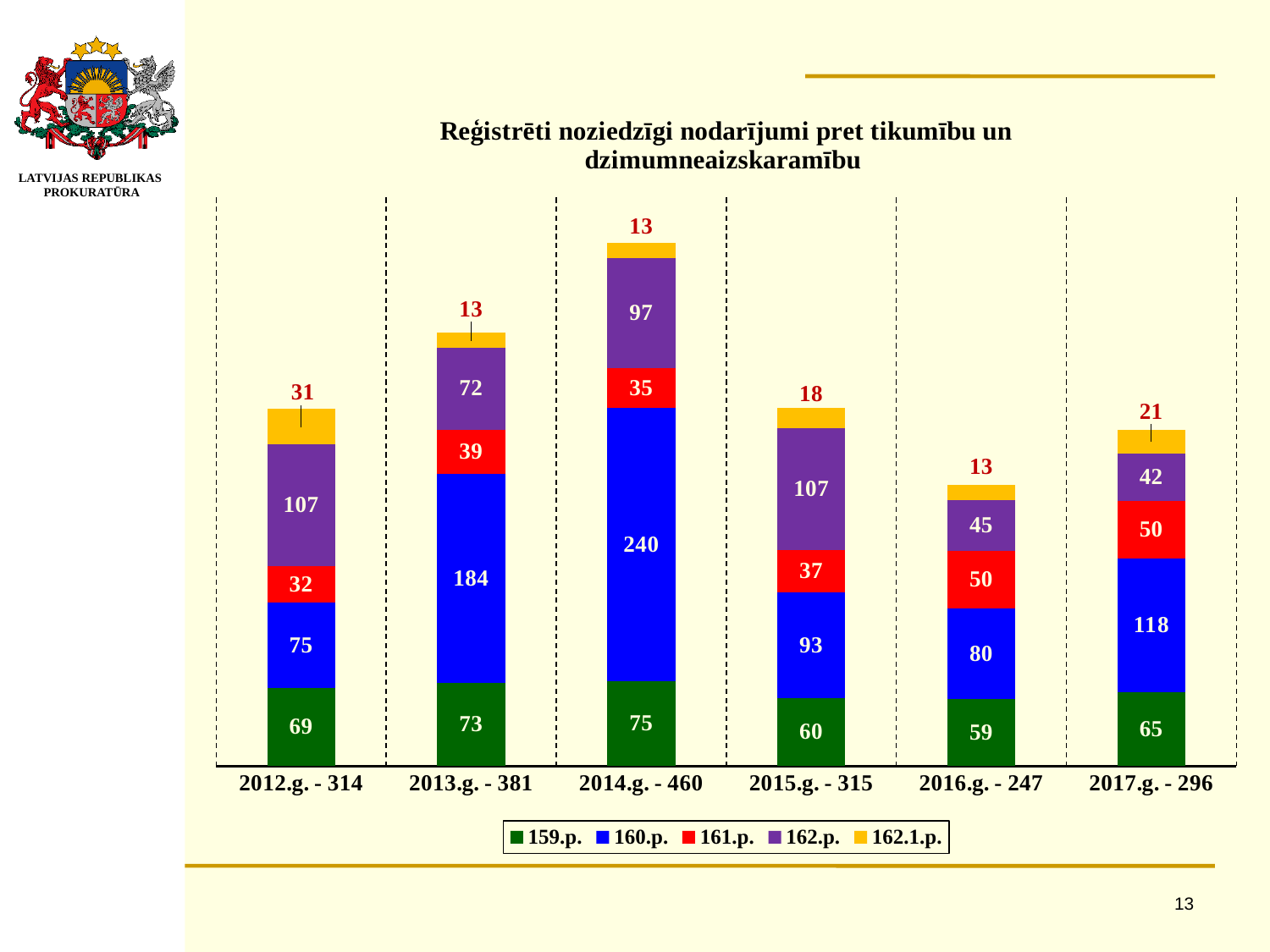
What type of chart is shown on the slide? stacked bar chart Which year has the lowest total of registered offences? 2016 Which year has the highest total of registered offences? 2014 What is the value for 162.p. in 2015? 107 How many years (categories) are shown on the x axis? 6 How many series does the legend list? 5 Which is larger, the 161.p. value in 2016 or in 2015? 2016 What is the total for the 2013 bar? 381 What is the value for 160.p. in 2014? 240 What is the difference between the 160.p. values in 2014 and 2013? 56 What is the value for 159.p. in 2016? 59 What is the value for 162.1.p. in 2017? 21